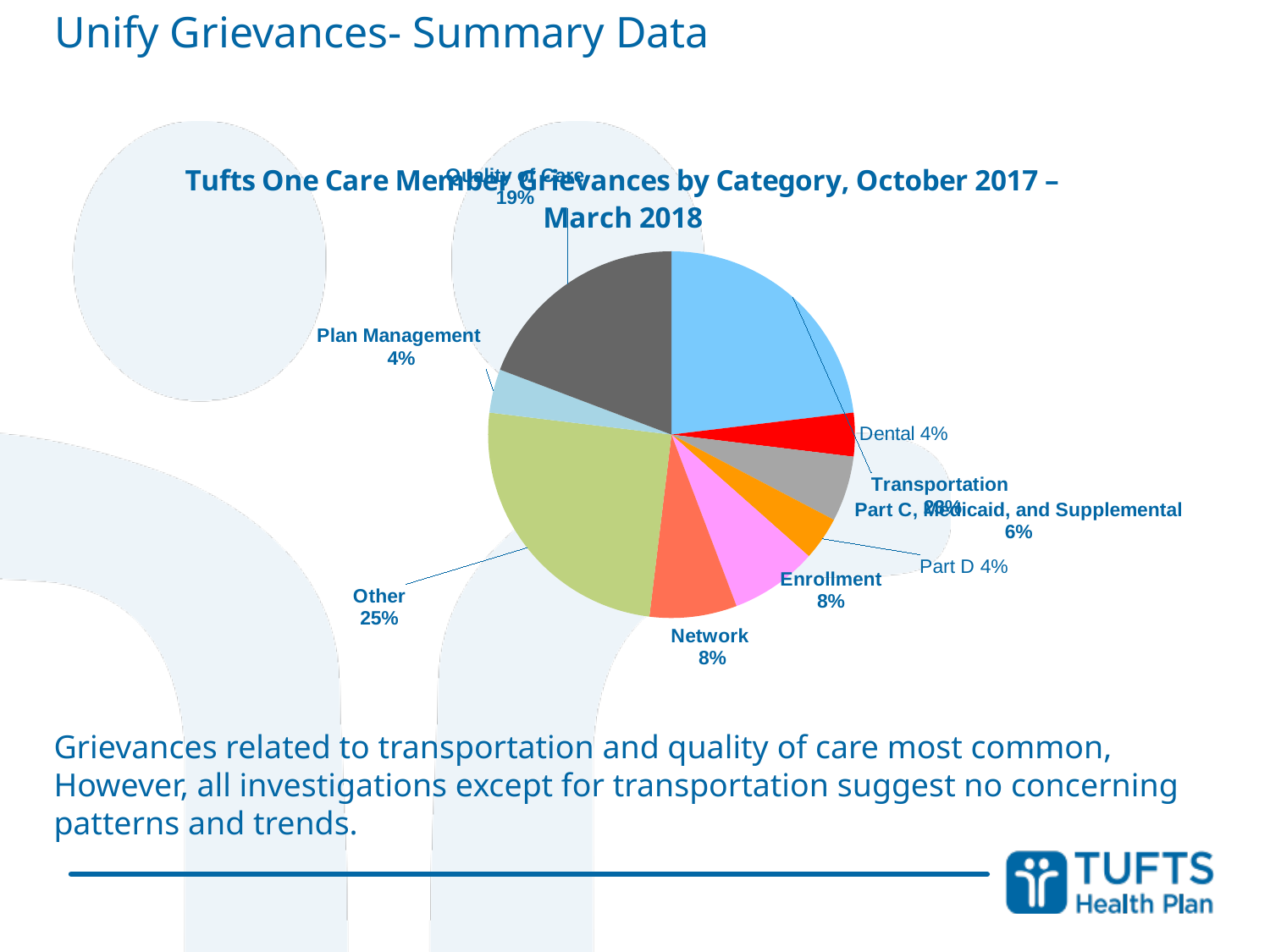
What percentage of grievances is attributed to Part D? 4% What percentage of grievances is attributed to Plan Management? 4% What percentage of grievances is attributed to Part C, Medicaid, and Supplemental? 6% What percentage of grievances is attributed to Network? 8% What kind of chart is shown on the slide? Pie chart What percentage of grievances is attributed to Enrollment? 8% Which category has a larger share of grievances, Other or Quality of Care? Other What share of grievances is in the Quality of Care category? 19% How many percentage points larger is the Other share than the Quality of Care share? 6 What is the title of the chart? Tufts One Care Member Grievances by Category, October 2017 – March 2018 What share of grievances is in the Other category? 25% What percentage of grievances is attributed to Dental? 4%